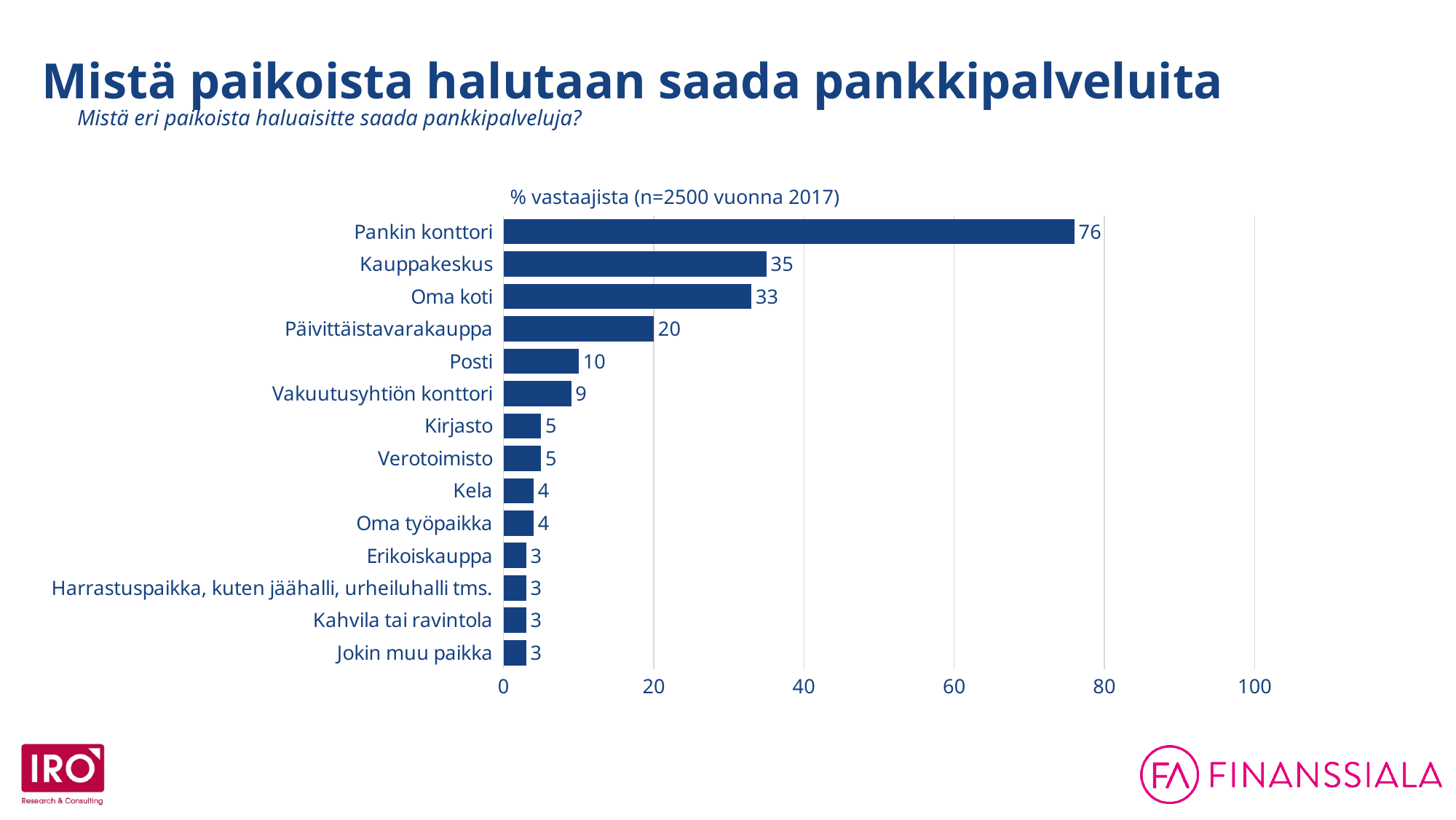
Is the value for Pankin konttori greater or less than 60? greater What is the value for Posti? 10 What is the value for Pankin konttori? 76 What is the value for Vakuutusyhtiön konttori? 9 What is the value for Oma koti? 33 Which category has the highest value? Pankin konttori Which is larger, the value for Päivittäistavarakauppa or the value for Posti? Päivittäistavarakauppa How many categories are shown in the chart? 14 What kind of chart is shown on the slide? bar chart What is the difference between the values for Pankin konttori and Kauppakeskus? 41 What is the difference between the values for Kauppakeskus and Oma koti? 2 What is the chart's title? % vastaajista (n=2500 vuonna 2017)